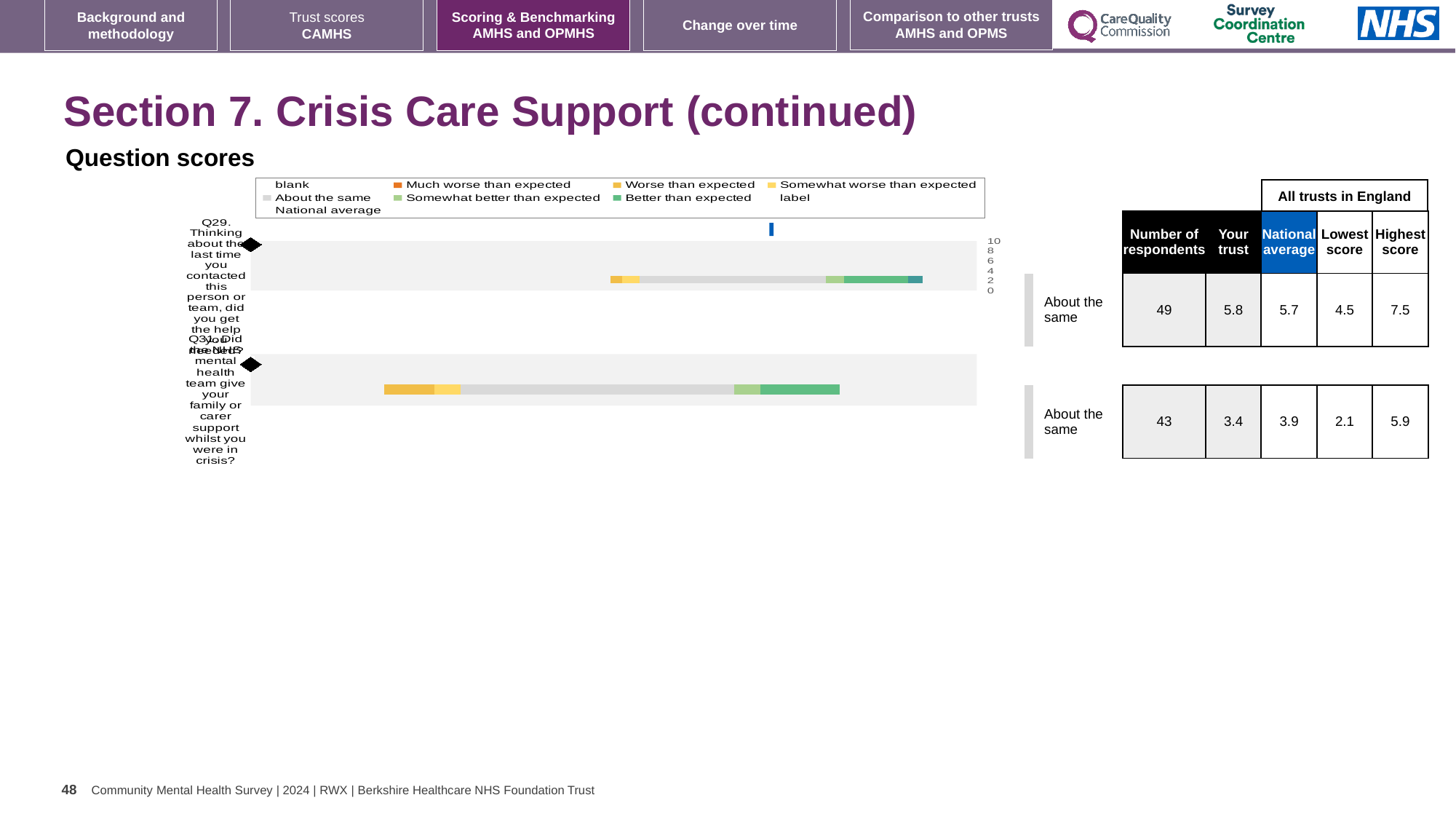
How many entries does the chart legend list? 9 What kind of chart is shown under the 'Question scores' heading? Bar chart Which question number is plotted in the bottom bar of the chart? Q31 How many question bars are plotted in the chart? 2 What is the lowest tick value shown on the chart's value axis? 0 Which question number is plotted in the top bar of the chart? Q29 What is the highest tick value shown on the chart's value axis? 10